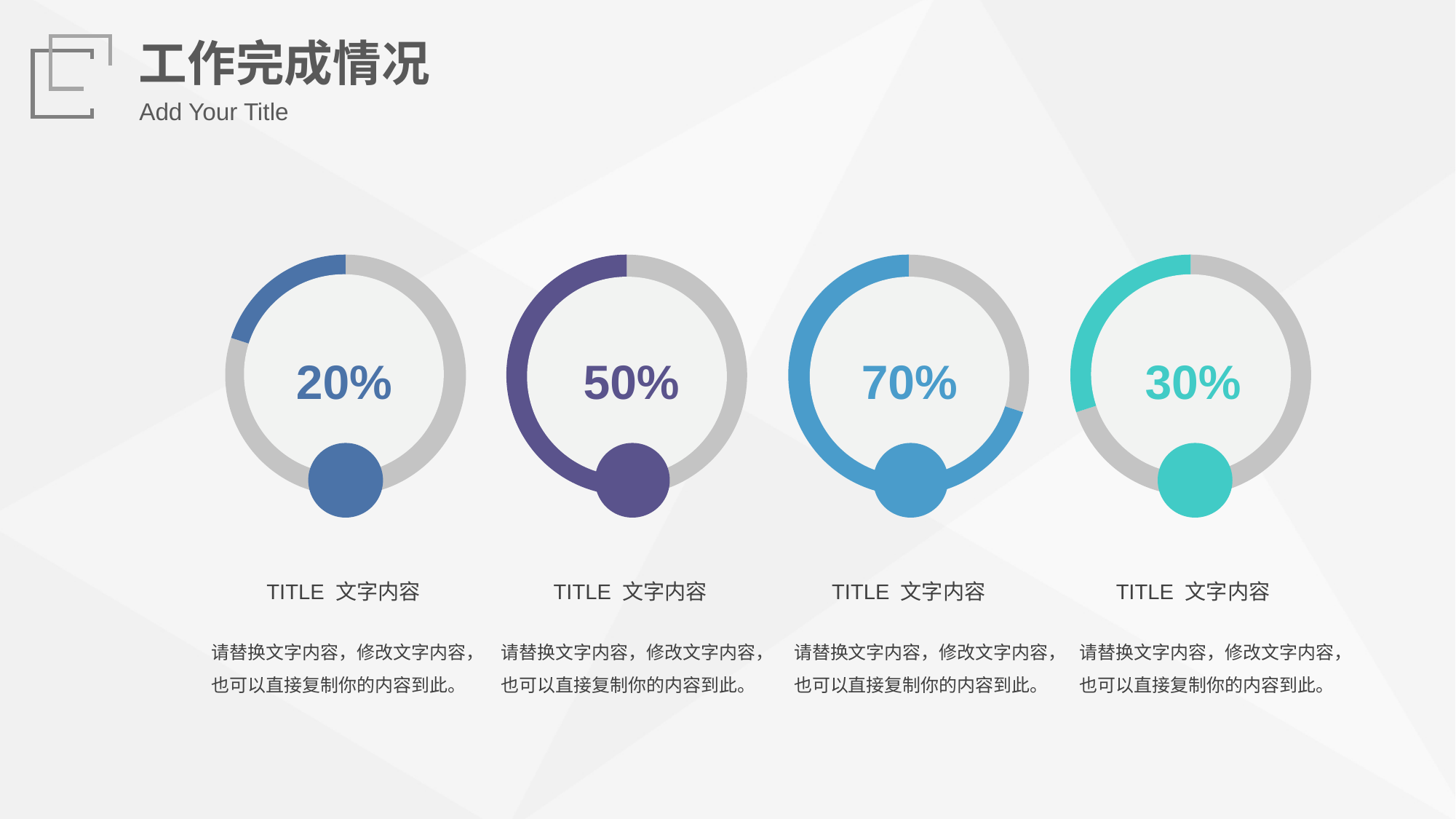
Which ring chart shows the lowest percentage? The leftmost (20%) What value is shown in the third ring chart from the left? 70% How many ring charts are shown on the slide? 4 What value is shown in the second ring chart from the left? 50% What value is shown in the rightmost ring chart? 30% What value is shown in the leftmost ring chart? 20% What kind of chart is used to display the percentages on the slide? Ring (donut) progress chart What is the difference between the value in the second ring chart and the value in the rightmost ring chart? 20% Which ring chart shows the highest percentage? The third from the left (70%) Which is larger, the value in the second ring chart or the value in the rightmost ring chart? The second ring chart (50%) What colour is the filled portion of the rightmost ring chart? Teal What is the difference between the value in the third ring chart and the value in the leftmost ring chart? 50%